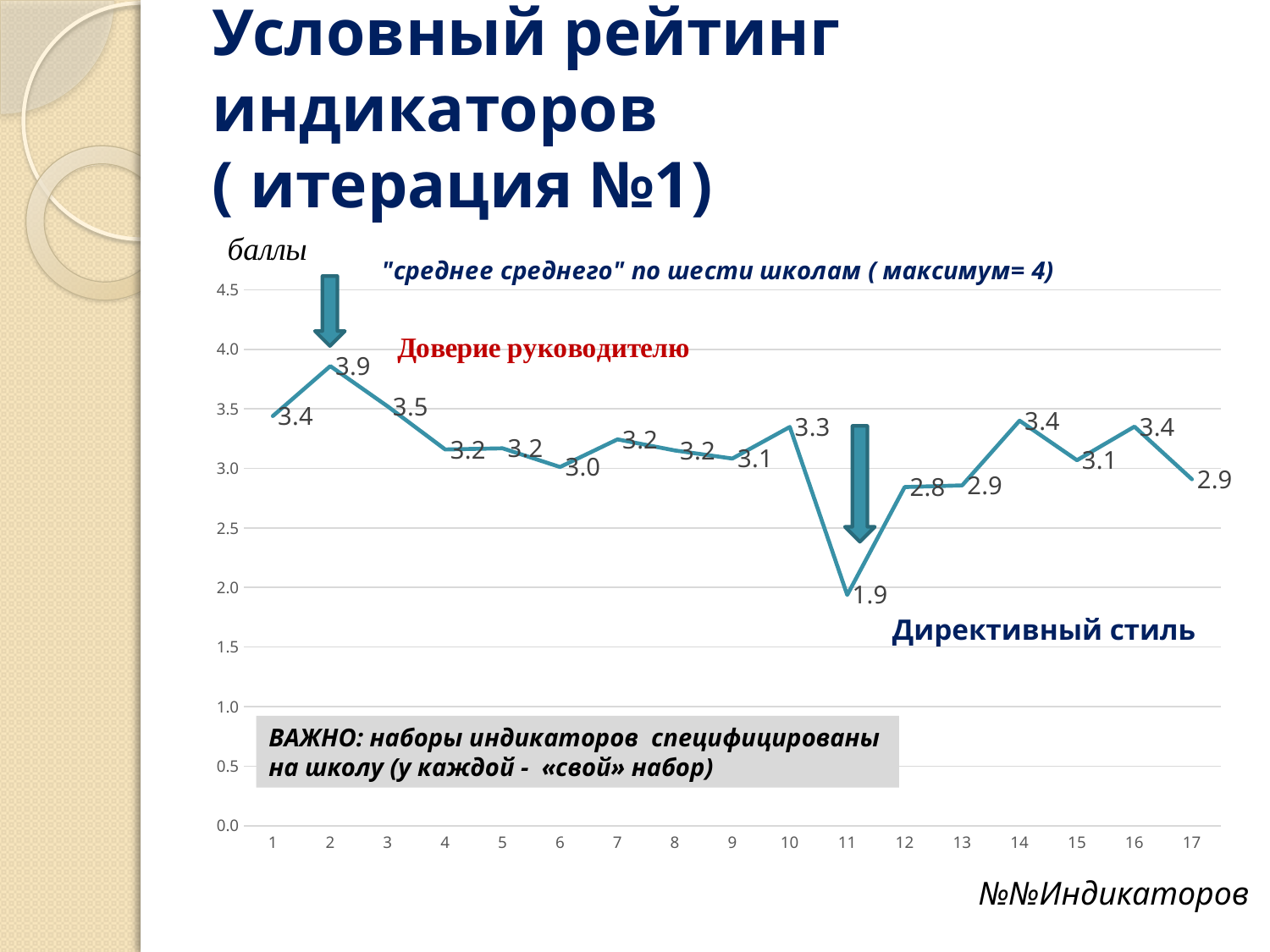
What is the value for indicator 17? 2.9 Which has a larger value, indicator 10 or indicator 12? indicator 10 Which indicator is labelled "Директивный стиль" on the chart? 11 How many indicators are plotted on the x axis? 17 What is the difference between the values for indicator 2 and indicator 11? 2.0 What kind of chart is shown on the slide? line chart What is the value for indicator 2? 3.9 Does the line rise or fall from indicator 14 to indicator 15? fall Is the value for indicator 11 greater or less than 2.0? less Which indicator number has the lowest value? 11 What is the value for indicator 11? 1.9 Which indicator number has the highest value? 2